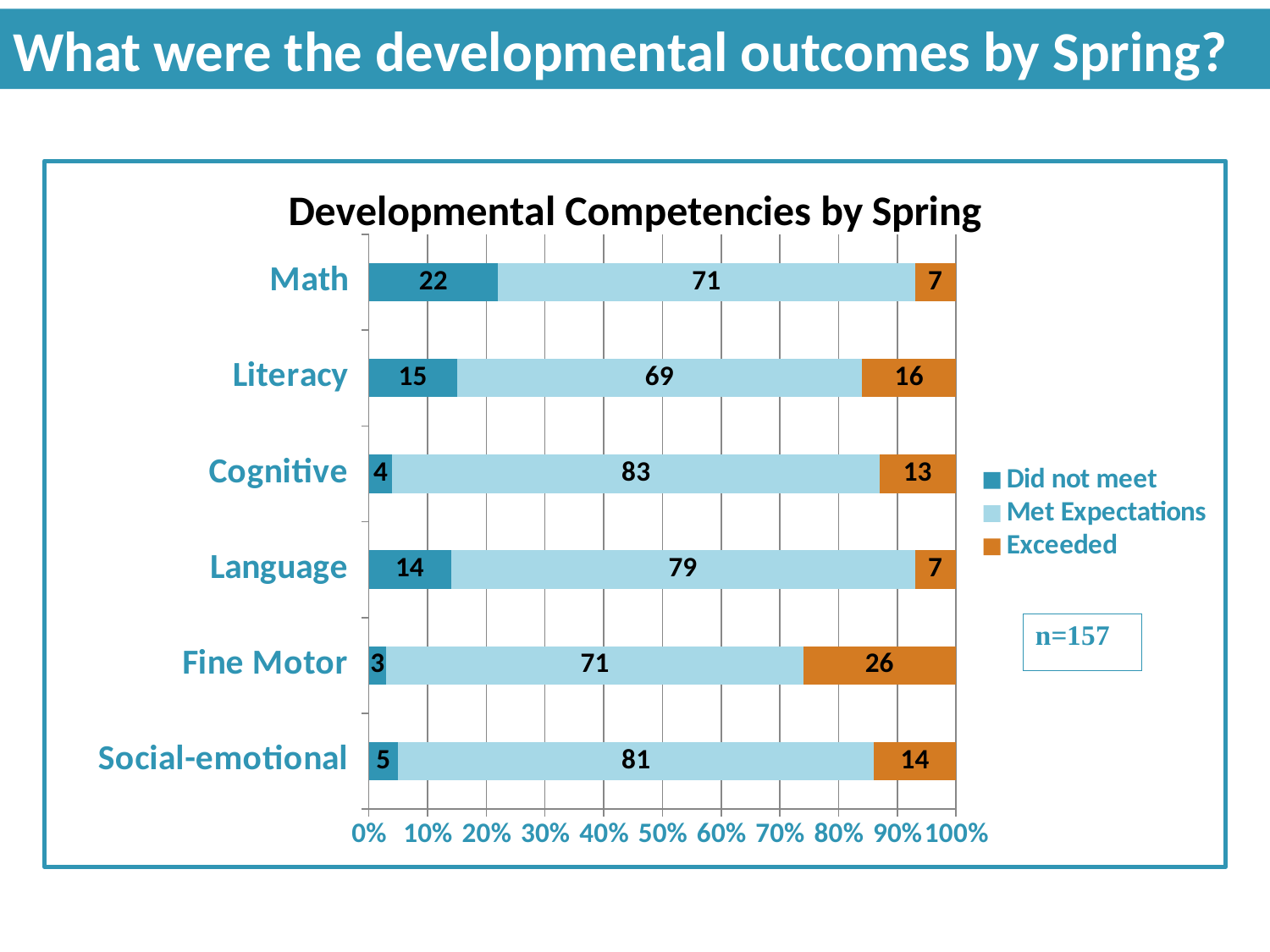
What kind of chart is shown on the slide? Stacked bar chart What is the difference between the 'Exceeded' values for Fine Motor and Literacy? 10 What is the title of the chart? Developmental Competencies by Spring Which category has the lowest 'Exceeded' value? Math and Language (both 7) How many series does the legend list? 3 What is the 'Exceeded' value for Fine Motor? 26 Which is larger, the 'Met Expectations' value for Language or for Literacy? Language What is the 'Did not meet' value for Math? 22 Which category has the highest 'Did not meet' value? Math How many categories are shown on the chart? 6 What is the 'Met Expectations' value for Cognitive? 83 What is the total of the stacked bar for Social-emotional? 100